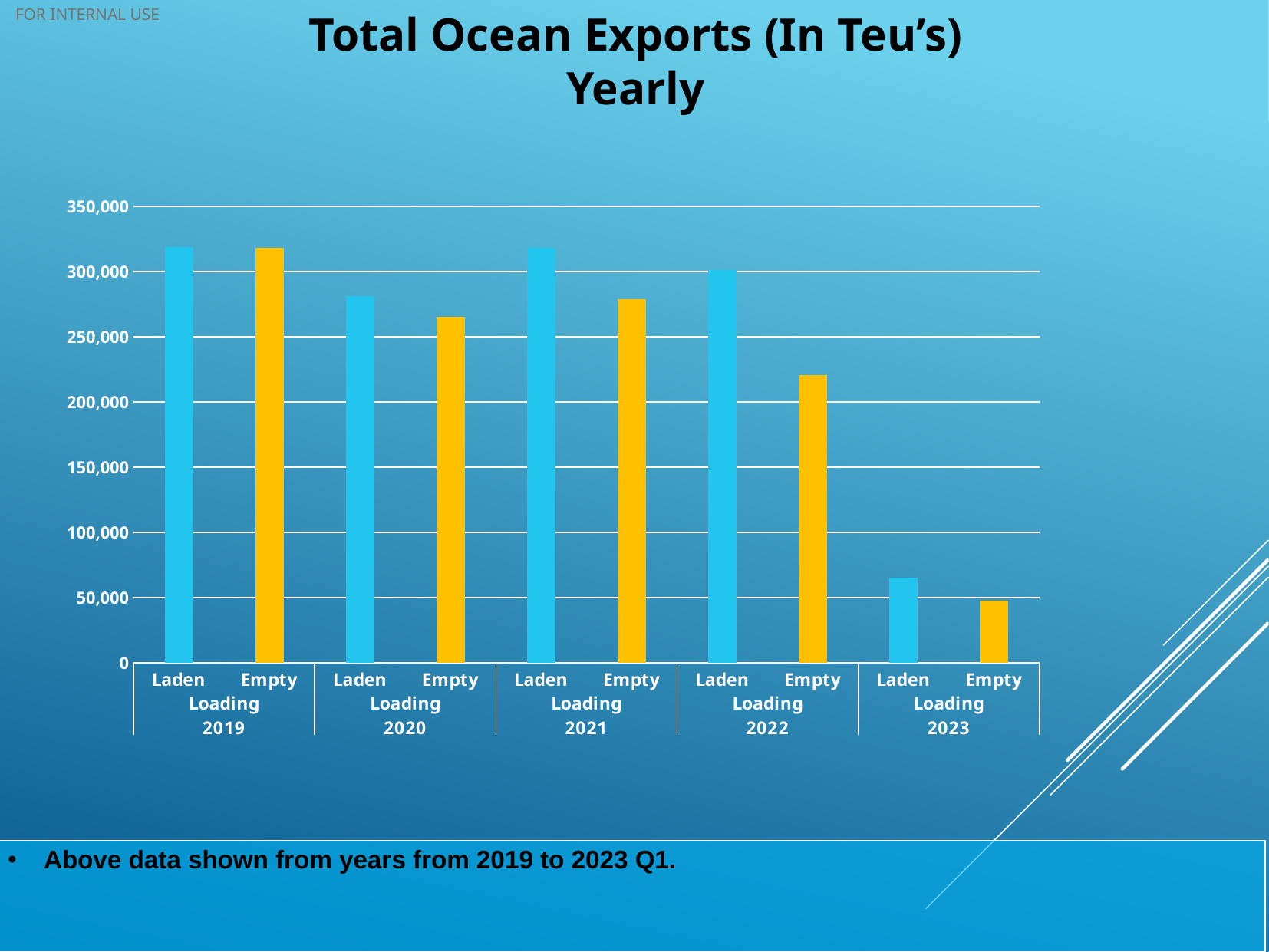
Is the value for Laden Loading in 2023 greater or less than 100,000? less Is the value for Laden Loading in 2019 greater or less than 300,000? greater Do the Laden Loading values rise or fall from 2021 to 2023? fall Which is larger in 2022, Laden Loading or Empty Loading? Laden Loading Is the value for Empty Loading in 2021 greater or less than 300,000? less How many bars are plotted in the chart? 10 Which is larger in 2023, Laden Loading or Empty Loading? Laden Loading Which bar has the lowest value in the chart? Empty Loading 2023 What is the title of the chart? Total Ocean Exports (In Teu's) Yearly What kind of chart is shown on the slide? bar chart How many years are shown on the x axis of the chart? 5